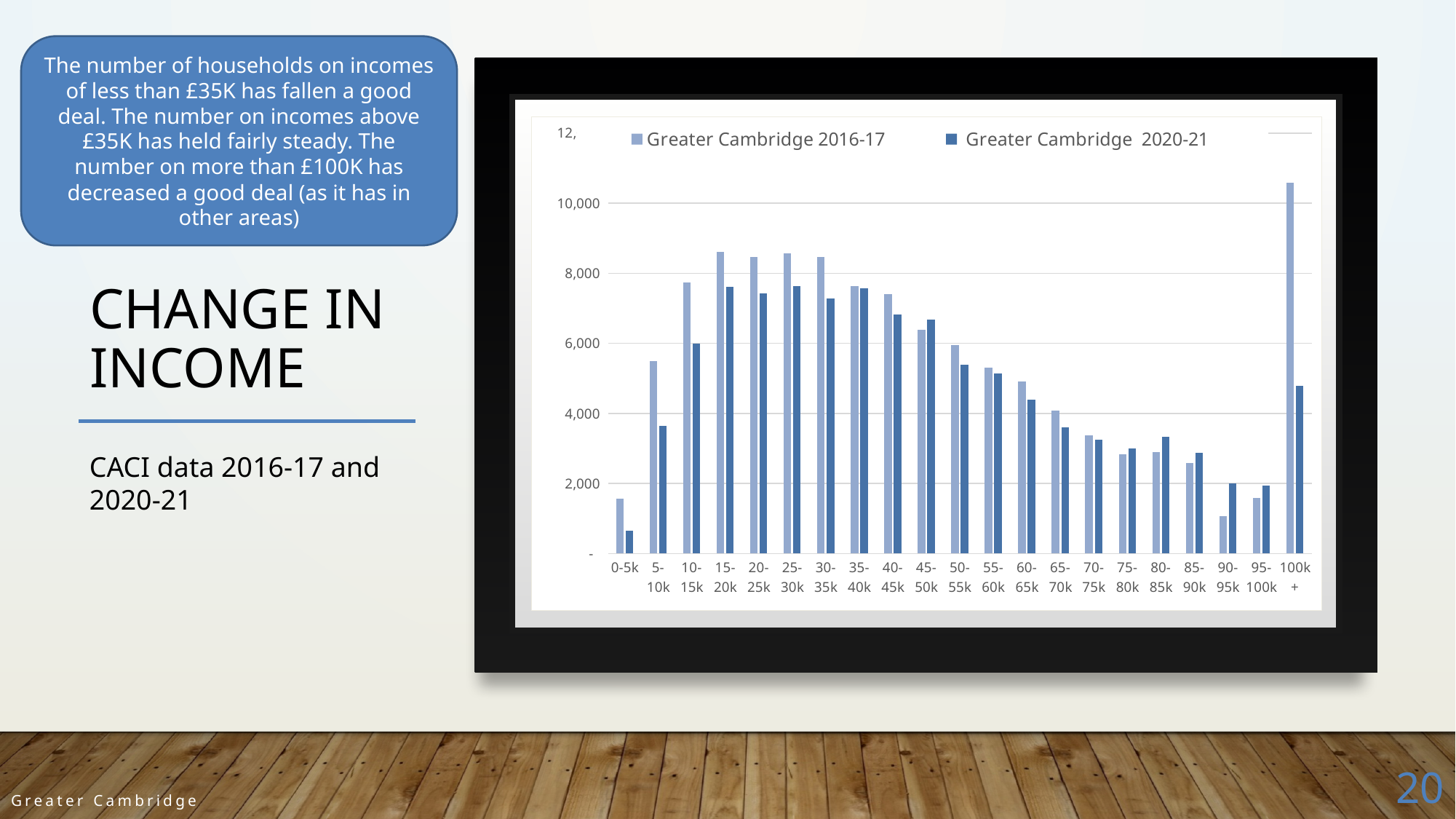
What kind of chart is shown on the slide? Bar chart For the 90-95k band, which series has the larger value: Greater Cambridge 2016-17 or Greater Cambridge 2020-21? Greater Cambridge 2020-21 Which income band has the lowest value for Greater Cambridge 2016-17? 90-95k Which income band has the lowest value for Greater Cambridge 2020-21? 0-5k Is the Greater Cambridge 2020-21 value for 100k + greater or less than 6,000? less How many income bands are shown along the x axis of the chart? 21 Which series is shown in the lighter blue colour in the chart? Greater Cambridge 2016-17 For the 0-5k band, which series has the larger value: Greater Cambridge 2016-17 or Greater Cambridge 2020-21? Greater Cambridge 2016-17 Is the Greater Cambridge 2020-21 value for 0-5k greater or less than 2,000? less How many series does the chart legend list? 2 Which income band has the highest value for Greater Cambridge 2016-17? 100k + Is the Greater Cambridge 2016-17 value for 100k + greater or less than 10,000? greater